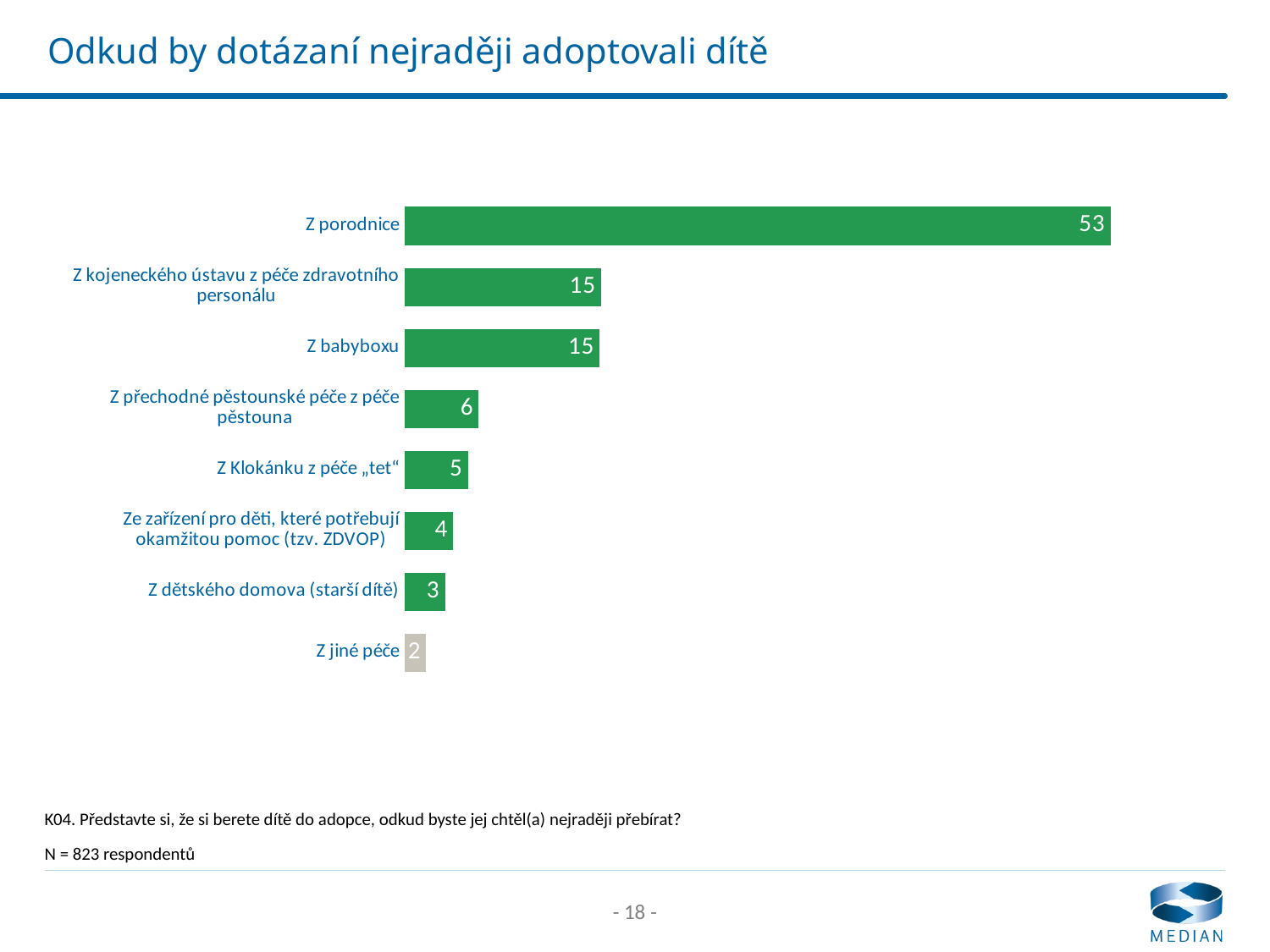
What kind of chart is shown on the slide? Bar chart What is the value for "Z dětského domova (starší dítě)"? 3 How many categories are shown in the chart? 8 Which is larger: the value for "Z Klokánku z péče „tet“" or the value for "Z dětského domova (starší dítě)"? Z Klokánku z péče „tet“ Which category has the lowest value? Z jiné péče What is the difference between the values for "Z porodnice" and "Z babyboxu"? 38 Which category has the highest value? Z porodnice What is the value for "Z porodnice"? 53 What is the difference between the values for "Z přechodné pěstounské péče z péče pěstouna" and "Ze zařízení pro děti, které potřebují okamžitou pomoc (tzv. ZDVOP)"? 2 What is the value for "Z Klokánku z péče „tet“"? 5 What is the title of the slide? Odkud by dotázaní nejraději adoptovali dítě What is the value for "Z babyboxu"? 15